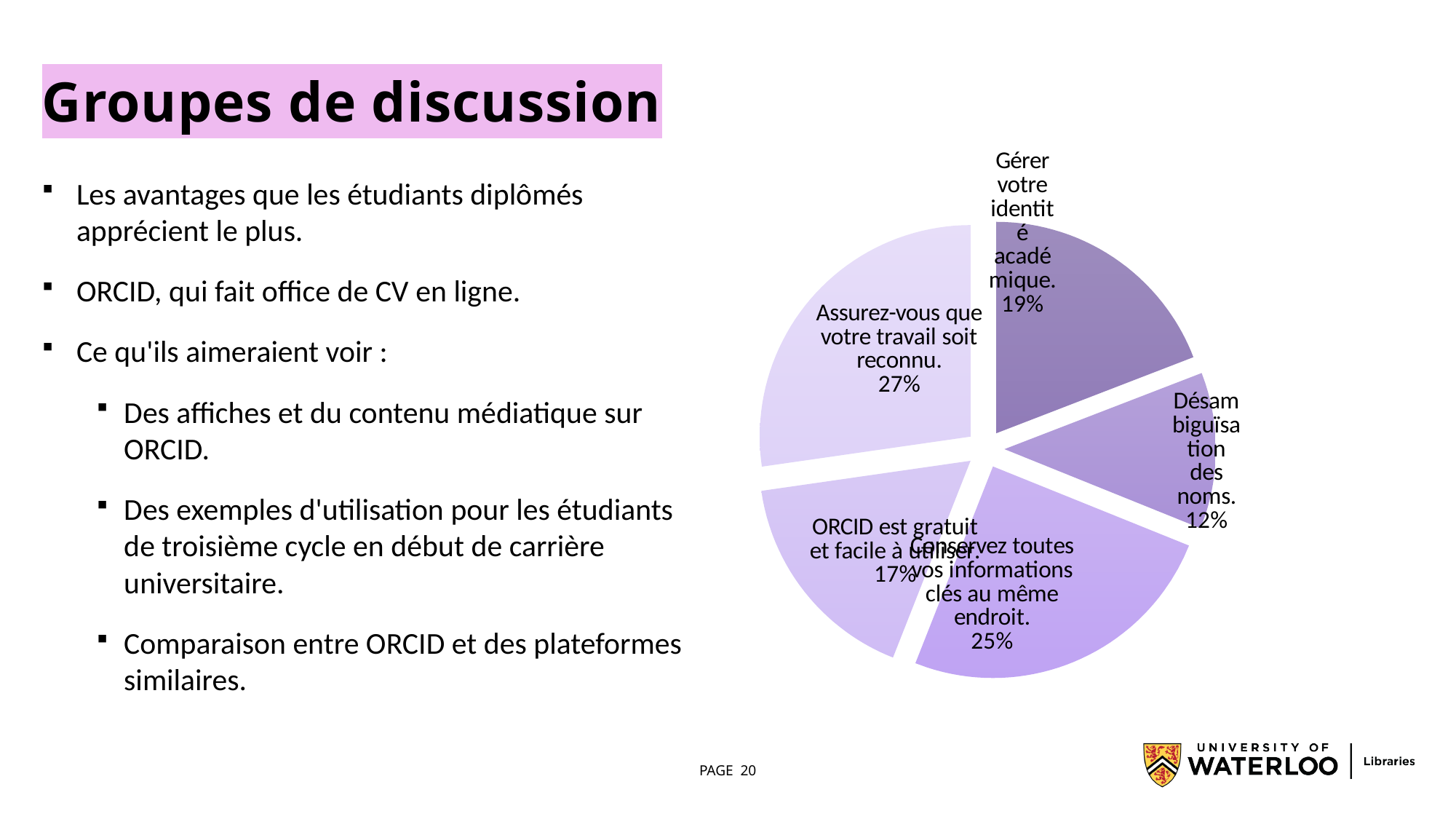
Which slice is larger: "Gérer votre identité académique." or "ORCID est gratuit et facile à utiliser."? Gérer votre identité académique. What percentage is shown for the slice "Conservez toutes vos informations clés au même endroit."? 25% What is the combined share of "Conservez toutes vos informations clés au même endroit." and "Assurez-vous que votre travail soit reconnu."? 52% What percentage is shown for the slice "ORCID est gratuit et facile à utiliser."? 17% What percentage is shown for the slice "Gérer votre identité académique."? 19% What percentage is shown for the slice "Désambiguïsation des noms."? 12% What percentage is shown for the slice "Assurez-vous que votre travail soit reconnu."? 27% Which slice of the pie chart has the smallest share? Désambiguïsation des noms. What kind of chart is shown on the slide? pie chart Which slice of the pie chart has the largest share? Assurez-vous que votre travail soit reconnu. How many slices does the pie chart have? 5 What is the difference in percentage points between "Assurez-vous que votre travail soit reconnu." and "Désambiguïsation des noms."? 15